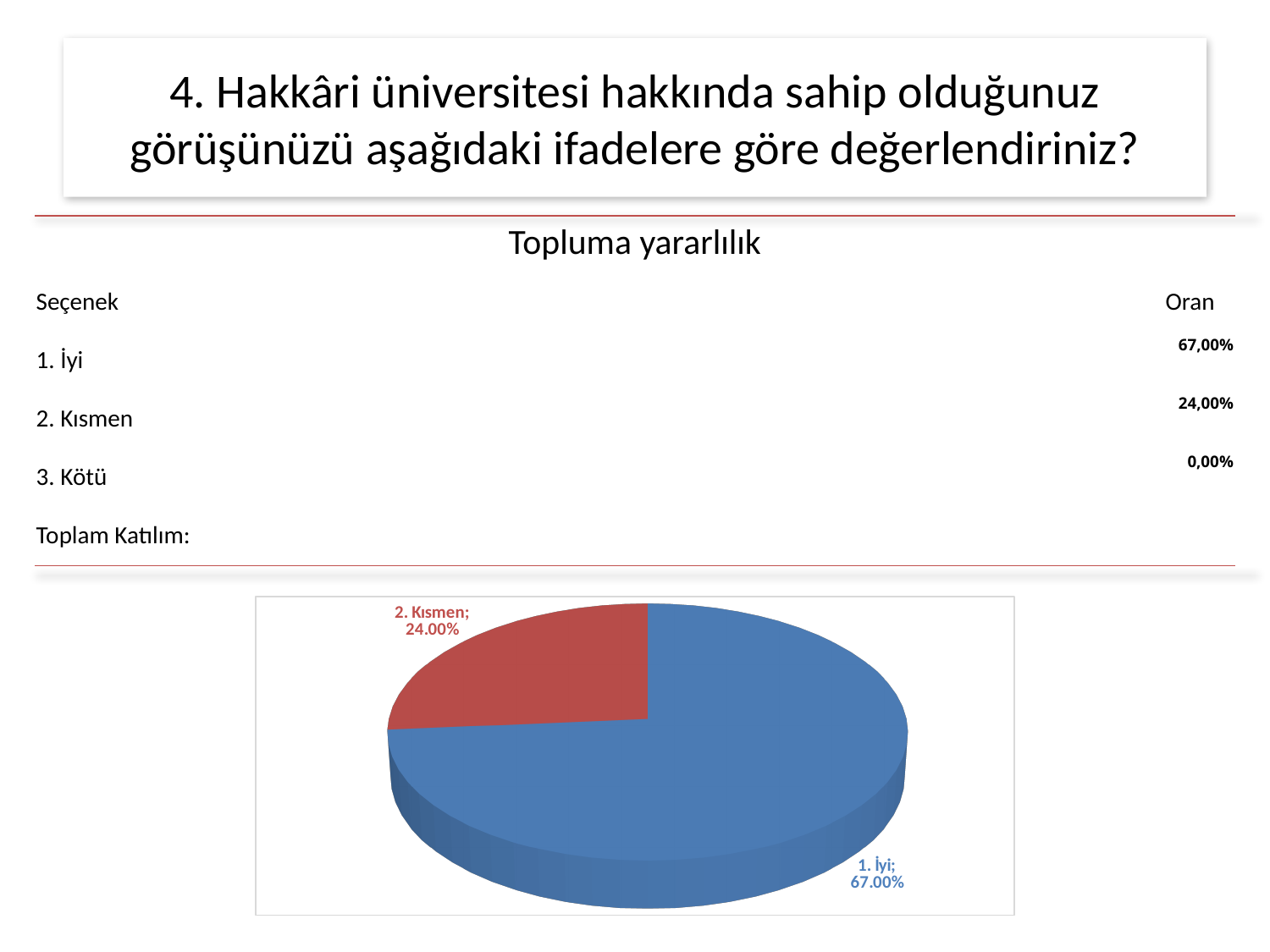
Which is larger in the pie chart, the slice for "1. İyi" or the slice for "2. Kısmen"? 1. İyi What colour is the "2. Kısmen" slice in the pie chart? red How many slices in the pie chart have data labels? 2 What is the value shown for the slice labelled "1. İyi" in the pie chart? 67.00% Which slice of the pie chart is the largest? 1. İyi What kind of chart is shown on the slide? pie chart Which labelled slice of the pie chart is the smallest? 2. Kısmen What colour is the "1. İyi" slice in the pie chart? blue What is the value shown for the slice labelled "2. Kısmen" in the pie chart? 24.00% What share of the pie does the "2. Kısmen" slice represent? 24.00% What is the difference between the "1. İyi" slice and the "2. Kısmen" slice in the pie chart? 43.00%